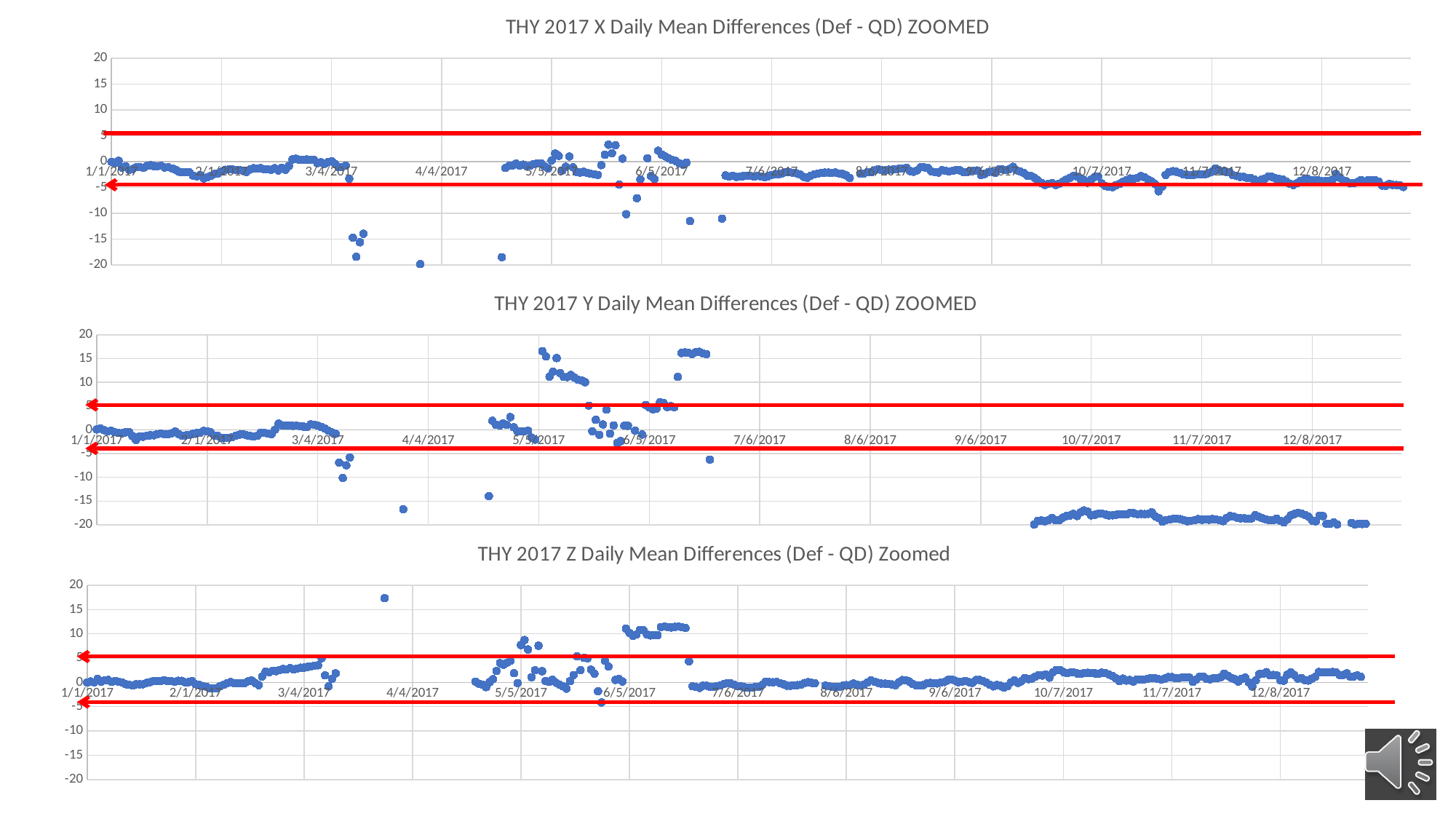
In the top chart (X Daily Mean Differences), are the values between 7/6/2017 and 9/6/2017 greater or less than -5? greater In the bottom chart (Z Daily Mean Differences), is the cluster of points just after 6/5/2017 greater or less than 5? greater In the middle chart (Y Daily Mean Differences), are the values after 10/7/2017 higher or lower than the values around 1/1/2017? lower In the top chart (X Daily Mean Differences), at what values are the two red horizontal lines drawn? 5 and -5 In the top chart (X Daily Mean Differences), is the lowest point near 4/4/2017 greater or less than -15? less How many charts are shown on the slide? 3 What kind of chart is the top chart, 'THY 2017 X Daily Mean Differences (Def - QD) ZOOMED'? scatter chart What is the title of the middle chart on the slide? THY 2017 Y Daily Mean Differences (Def - QD) ZOOMED